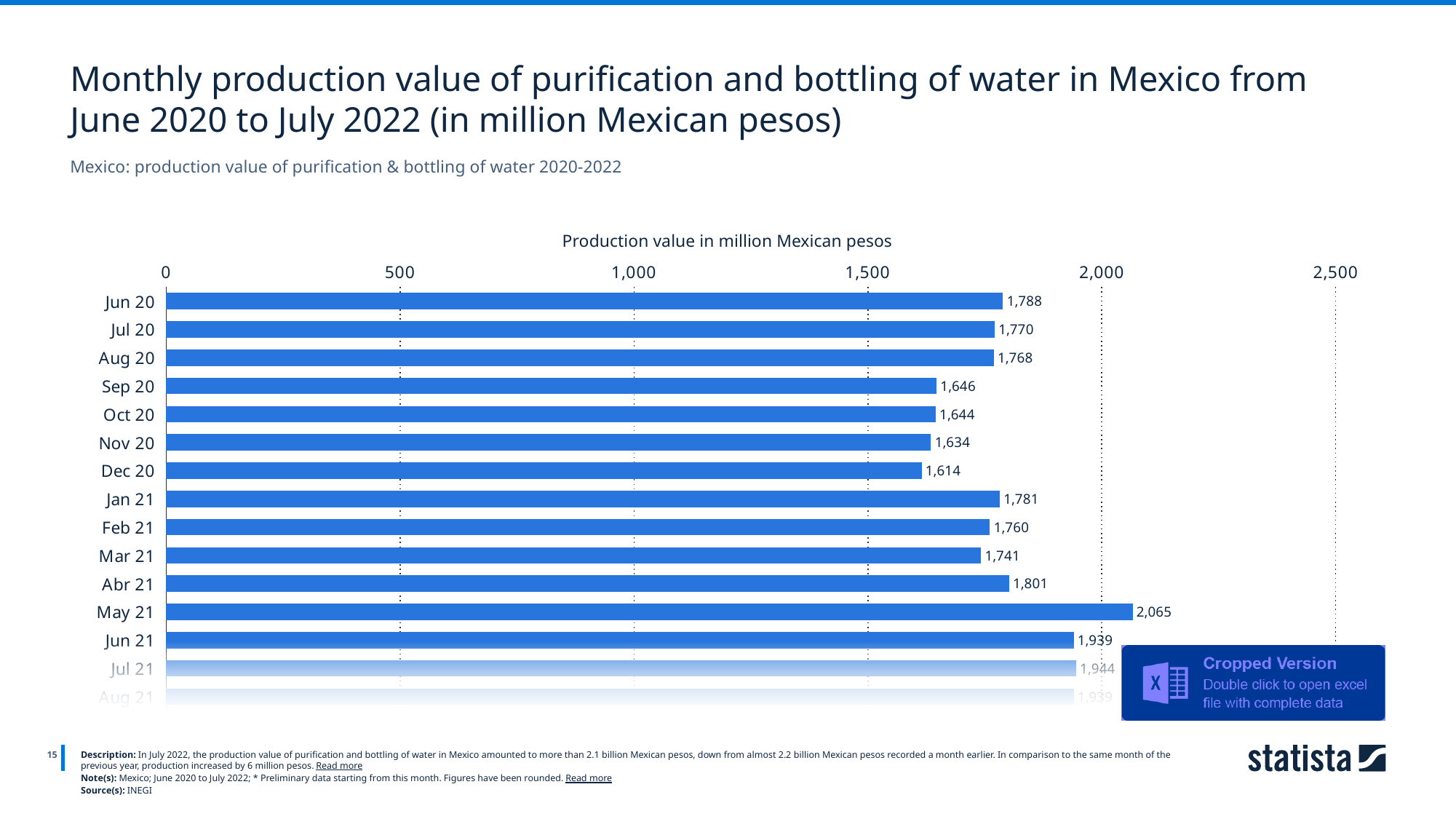
What is the production value for Dec 20? 1,614 What is the production value for Jun 20? 1,788 Is the value for May 21 greater or less than 2,000? greater Which month shown has the lowest production value? Dec 20 Which month shown has the highest production value? May 21 What is the axis title shown above the chart? Production value in million Mexican pesos What kind of chart is shown on the slide? Bar chart What is the difference between the production values for Jun 20 and Dec 20? 174 What is the difference between the production values for May 21 and Jun 21? 126 What is the production value for Abr 21? 1,801 Which has a larger production value, Sep 20 or Jan 21? Jan 21 What is the production value for May 21? 2,065